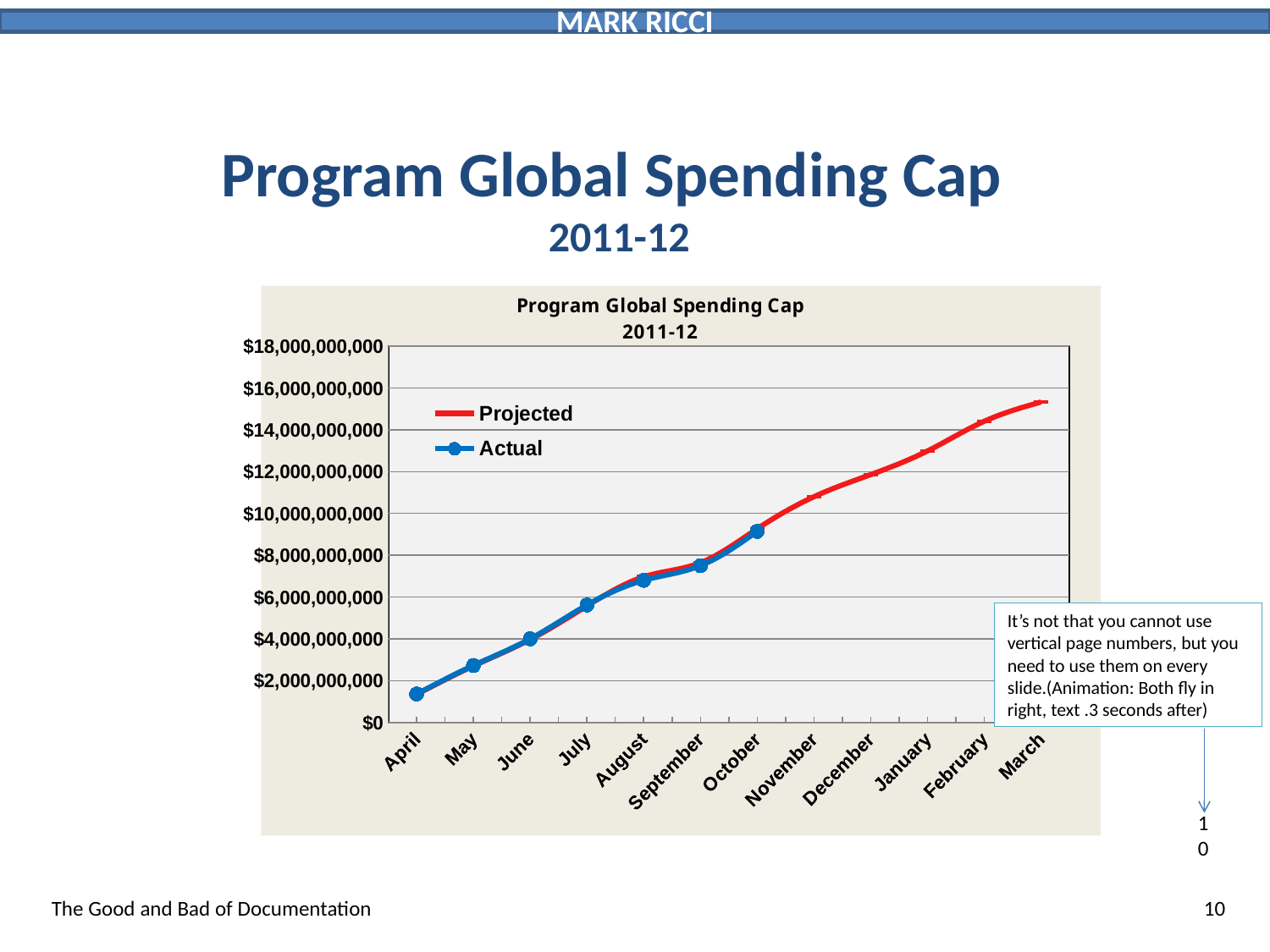
In which month is the Actual value lowest? April How many months are shown along the x axis of the chart? 12 Is the Actual value for April greater or less than $2,000,000,000? less How many series does the chart's legend list? 2 What is the title of the chart? Program Global Spending Cap 2011-12 Do the Projected values rise or fall from April to March? rise What kind of chart is shown on the slide? line chart Is the Projected value for November greater or less than $10,000,000,000? greater Is the Projected value for March greater or less than $14,000,000,000? greater In which month is the Projected value highest? March Which series is drawn in red in the chart? Projected